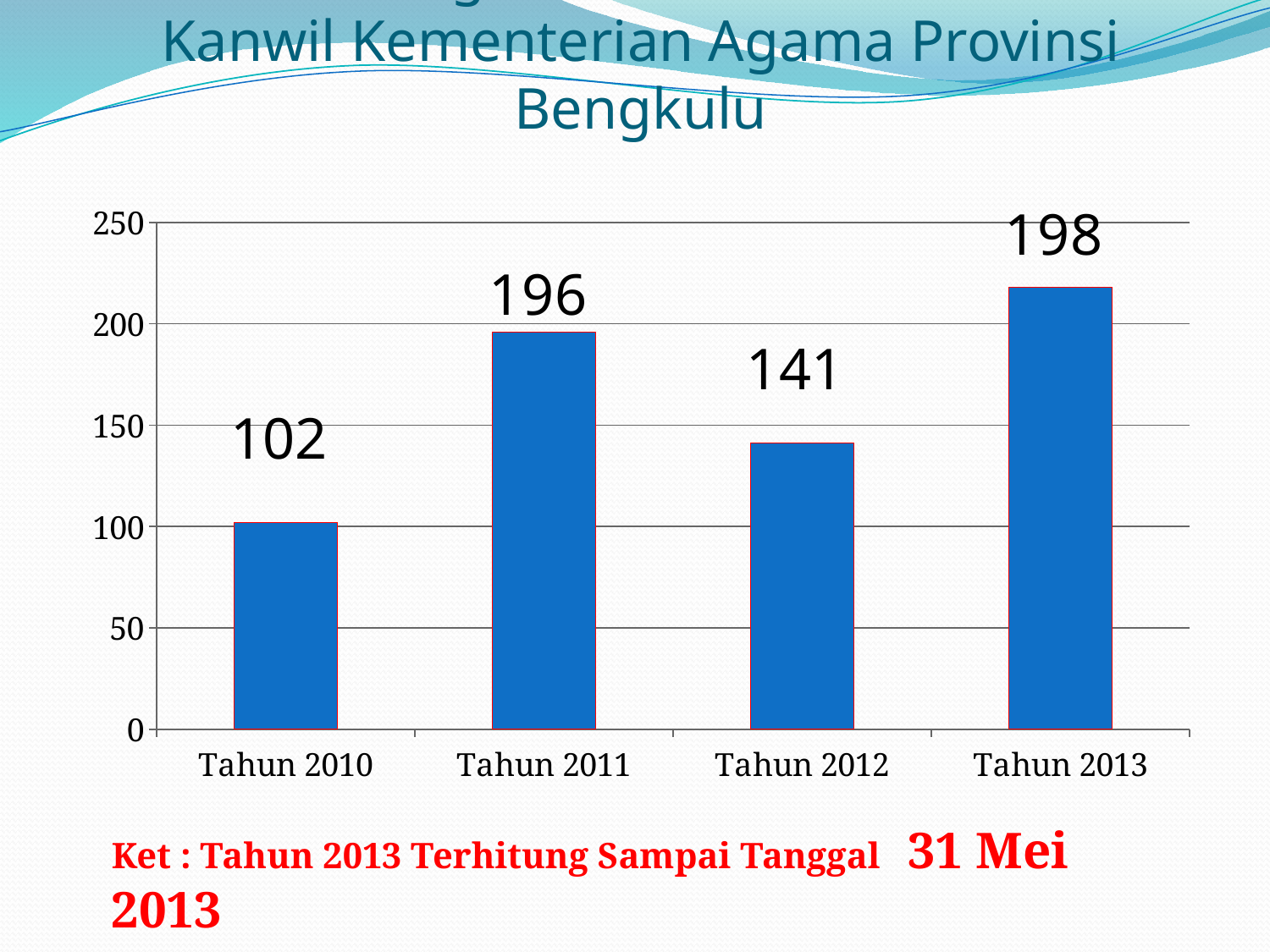
What is the value for Tahun 2013? 198 Which year has the highest value? Tahun 2013 Which is larger, the value for Tahun 2012 or the value for Tahun 2010? Tahun 2012 What is the difference between the values for Tahun 2011 and Tahun 2010? 94 Which year has the lowest value? Tahun 2010 What is the value for Tahun 2012? 141 What is the value for Tahun 2011? 196 How many years are shown on the x axis? 4 What kind of chart is shown on the slide? bar chart What is the value for Tahun 2010? 102 Is the value for Tahun 2012 greater or less than 150? less What is the difference between the values for Tahun 2013 and Tahun 2012? 57